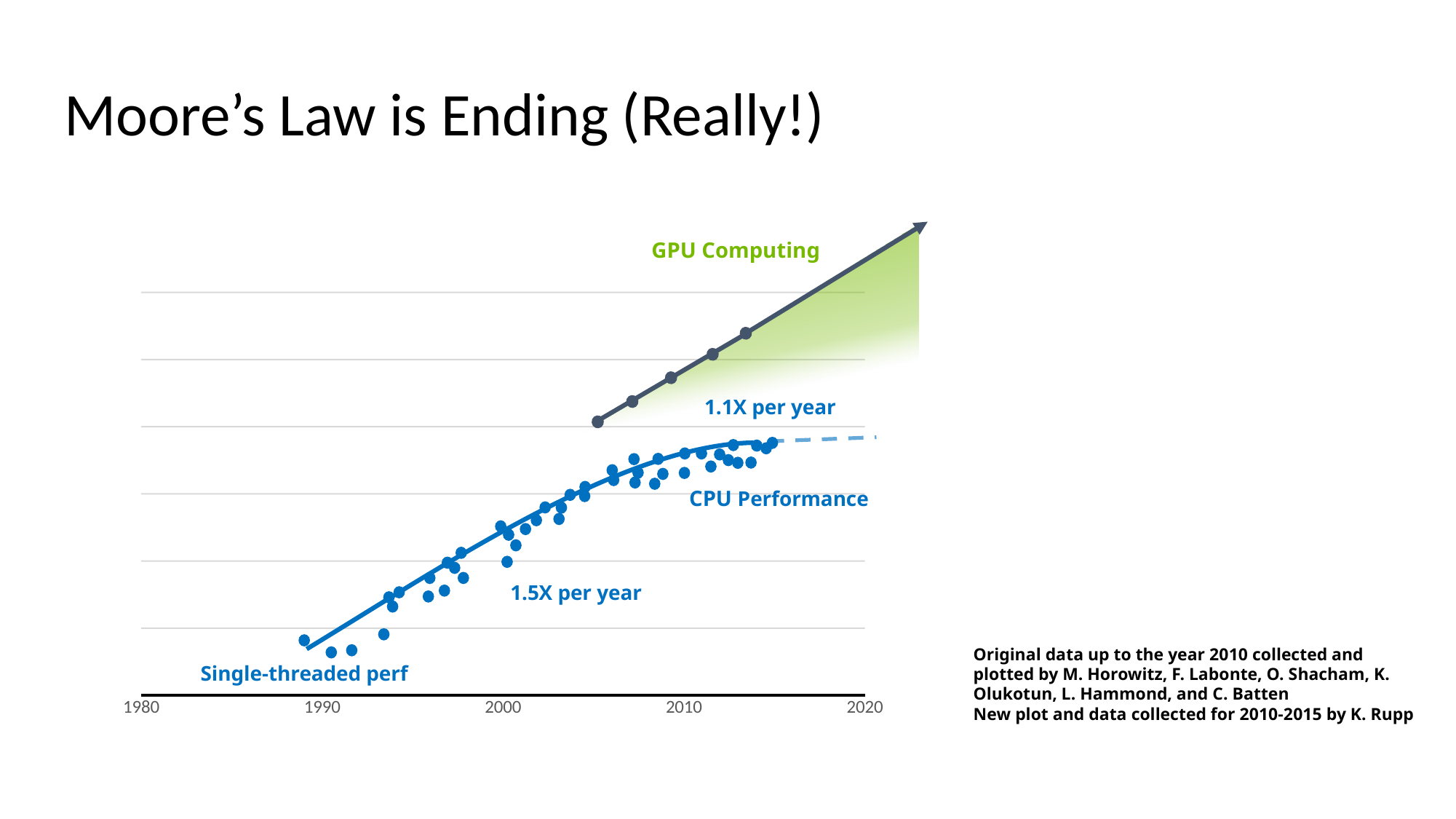
What kind of chart is shown on the slide? Scatter chart with trend lines What growth rate is labelled on the early part of the CPU performance curve? 1.5X per year What is the first year shown on the x axis? 1980 How many data points are plotted on the GPU Computing line? 5 Which labelled growth rate is larger, 1.5X per year or 1.1X per year? 1.5X per year Does CPU performance rise or fall along the x axis from 1990 to 2010? Rise What is the title of the slide containing the chart? Moore's Law is Ending (Really!) Does the GPU Computing line rise or fall along the x axis? Rise What label is given to the blue data series at the bottom left of the chart? Single-threaded perf Around 2012, which is plotted higher on the chart, GPU Computing or CPU Performance? GPU Computing What is the last year shown on the x axis? 2020 What growth rate is labelled on the later, flattening part of the CPU performance curve? 1.1X per year